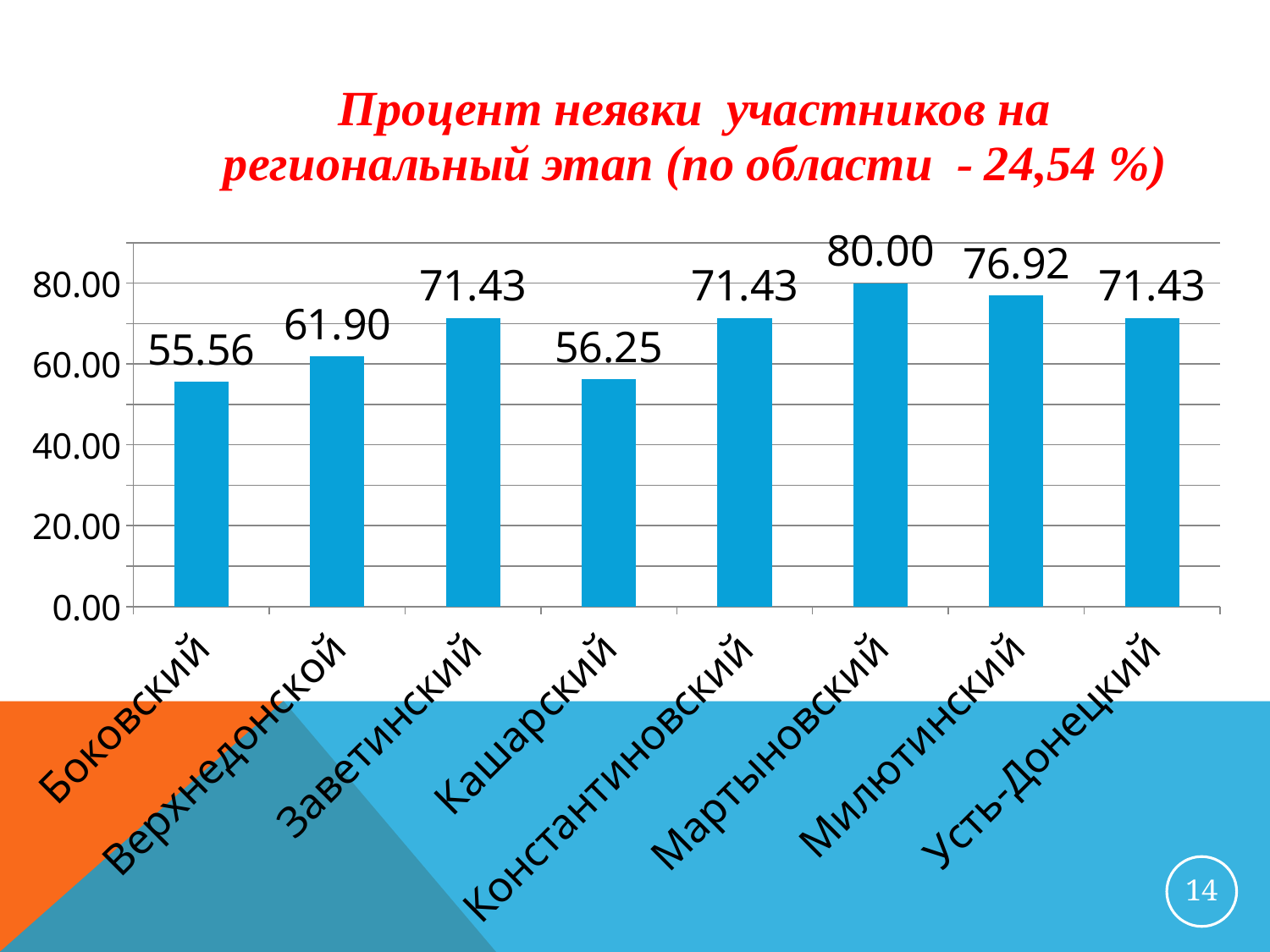
Which category has the highest value? Мартыновский What is the value for Кашарский? 56.25 What is the value for Милютинский? 76.92 What kind of chart is shown on the slide? bar chart What is the value for Мартыновский? 80.00 Which category has the lowest value? Боковский Is the value for Заветинский greater or less than 60.00? greater Which is larger, the value for Верхнедонской or the value for Кашарский? Верхнедонской How many categories are shown on the x axis? 8 What is the value for Боковский? 55.56 What is the difference between the values for Мартыновский and Боковский? 24.44 What percentage for the whole region is given in the chart title? 24,54 %